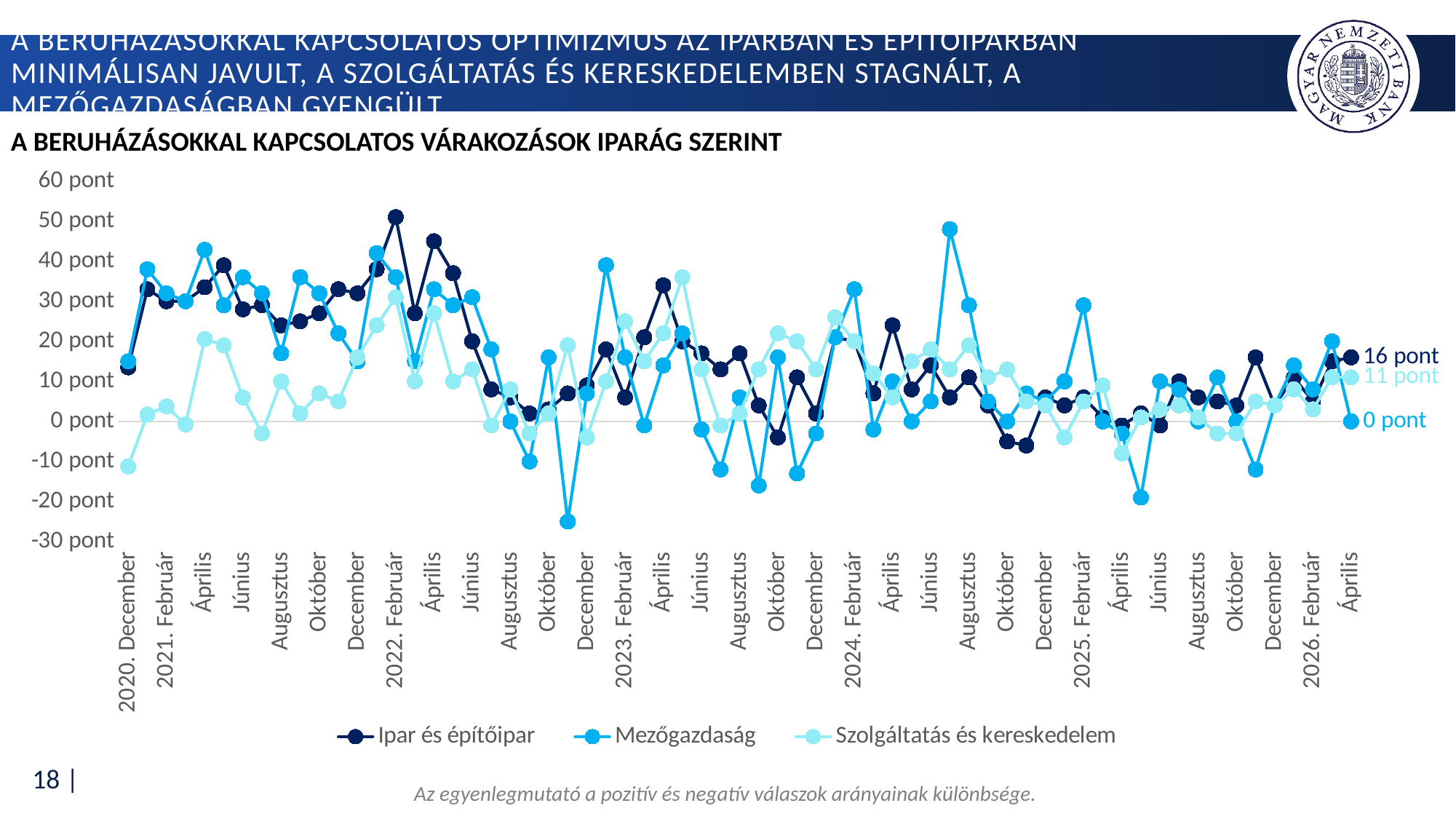
What is the value for Ipar és építőipar at the last point (2026. Április)? 16 pont What is the value for Mezőgazdaság at the last point (2026. Április)? 0 pont At the last point, which series has the highest value? Ipar és építőipar What is the value for Szolgáltatás és kereskedelem at the last point (2026. Április)? 11 pont Is the value for Mezőgazdaság in 2022. Október greater or less than -20 pont? greater How many series does the legend list? 3 At the last point, which series has the lowest value? Mezőgazdaság Is the value for Ipar és építőipar in 2022. Február greater or less than 40 pont? greater At the last point, what is the difference between Ipar és építőipar and Mezőgazdaság? 16 pont At the last point, what is the difference between Ipar és építőipar and Szolgáltatás és kereskedelem? 5 pont Does the Mezőgazdaság line rise or fall between 2024. Augusztus and 2025. Június? fall What kind of chart is shown on the slide? line chart